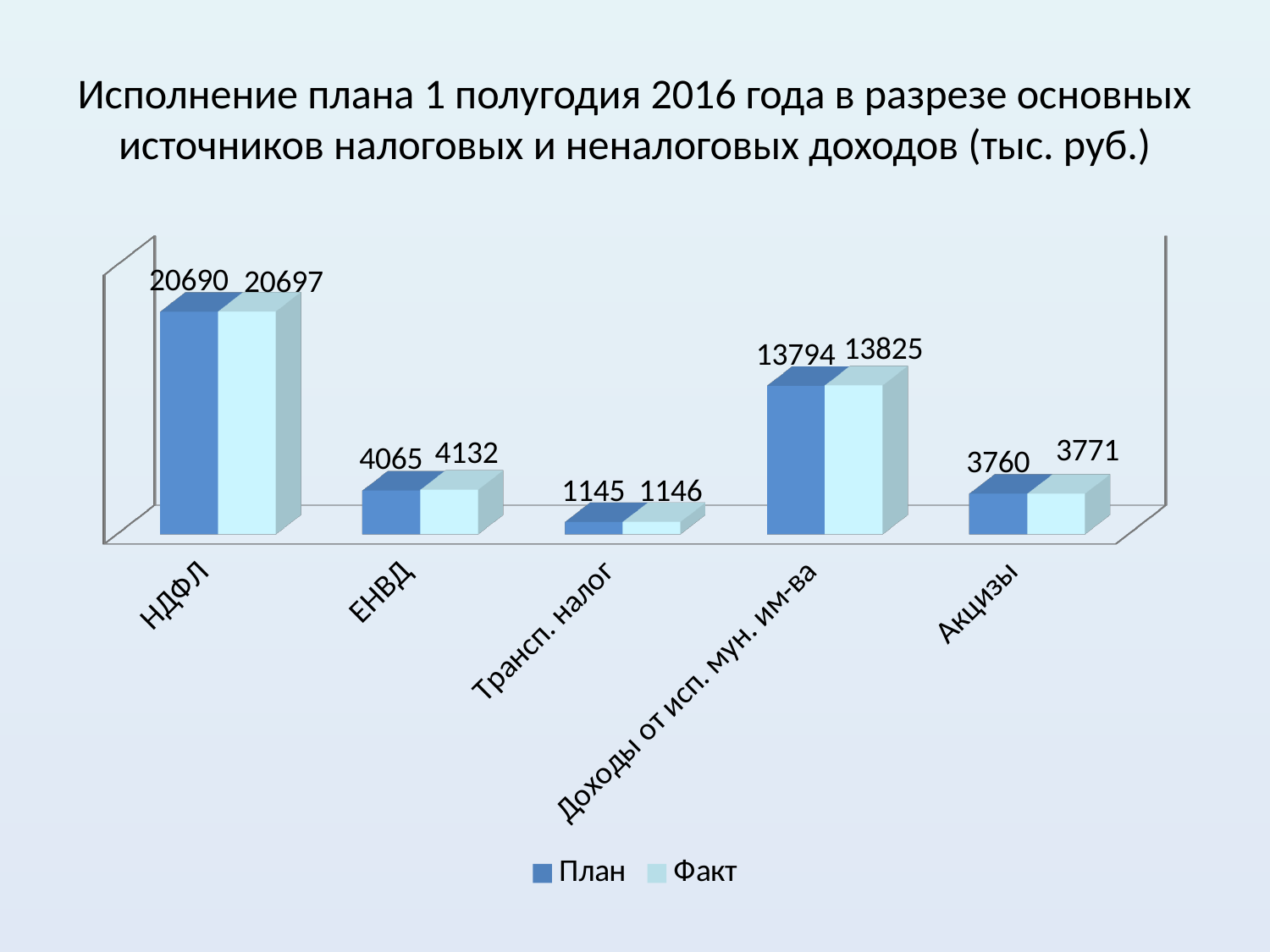
How many series does the legend list? 2 Which category has the highest Факт value? НДФЛ Which is larger: the План value for ЕНВД or the План value for Акцизы? ЕНВД Which category has the lowest План value? Трансп. налог What is the План value for НДФЛ? 20690 What kind of chart is shown on the slide? Bar chart What is the difference between the Факт and План values for Доходы от исп. мун. им-ва? 31 What is the Факт value for ЕНВД? 4132 What is the Факт value for Доходы от исп. мун. им-ва? 13825 How many categories are shown on the x axis? 5 What is the difference between the Факт and План values for ЕНВД? 67 What is the План value for Акцизы? 3760